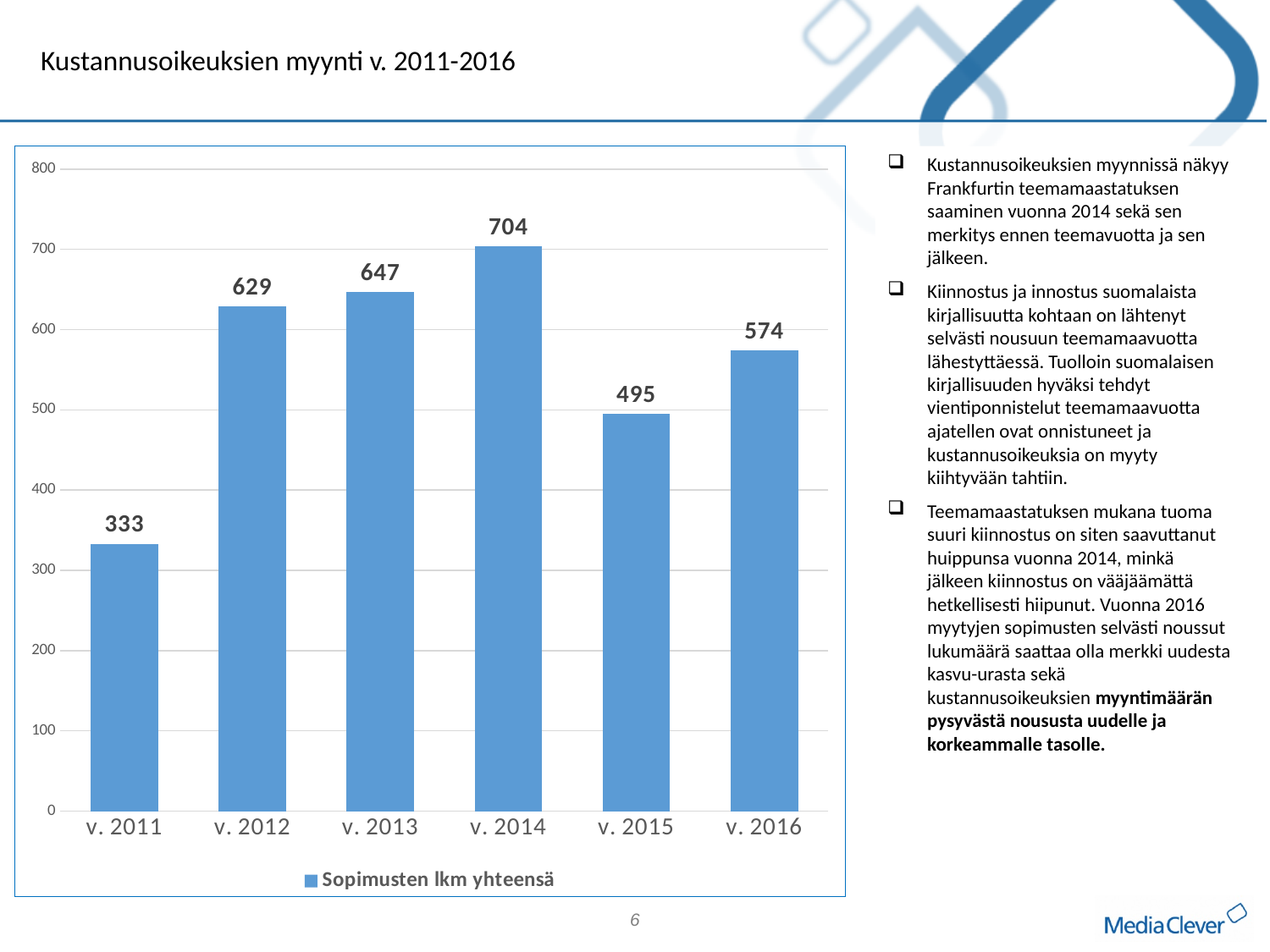
What is the difference between the values for v. 2014 and v. 2015? 209 Which is larger, the value for v. 2013 or the value for v. 2016? v. 2013 What is the value for v. 2016? 574 Which year has the highest value? v. 2014 What is the difference between the values for v. 2012 and v. 2011? 296 Is the value for v. 2015 greater or less than 500? less What is the value for v. 2011? 333 What is the value for v. 2014? 704 What kind of chart is shown on the slide? bar chart How many years are shown on the x axis? 6 Which year has the lowest value? v. 2011 What is the legend entry for the series shown in the chart? Sopimusten lkm yhteensä